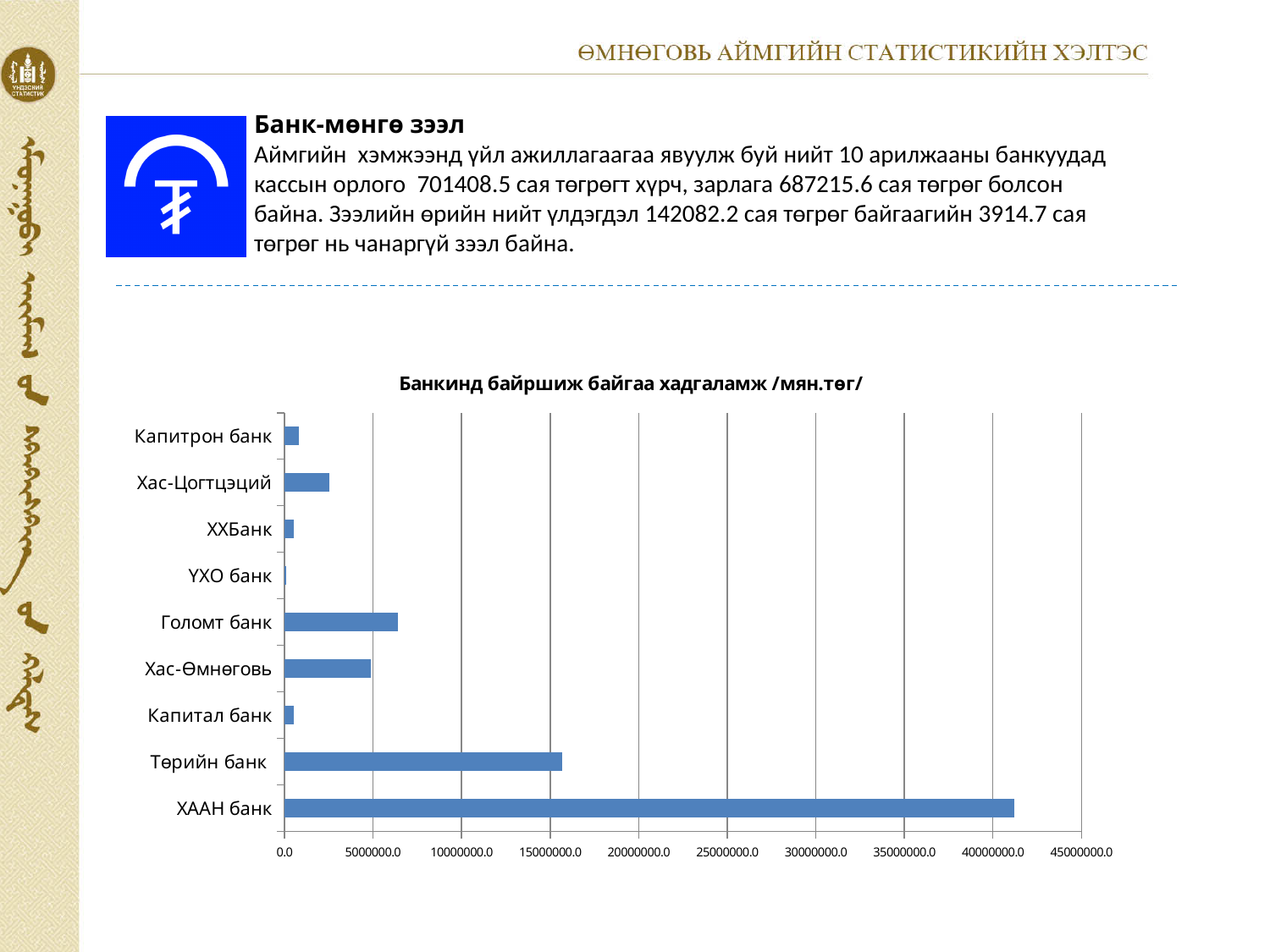
Is the value for ХААН банк greater or less than 40000000.0? greater Is the value for Хас-Цогтцэций greater or less than 5000000.0? less Which is larger, the value for Капитрон банк or the value for ХХБанк? Капитрон банк Is the value for Төрийн банк greater or less than 20000000.0? less Which is larger, the value for Төрийн банк or the value for Голомт банк? Төрийн банк What is the title of the chart? Банкинд байршиж байгаа хадгаламж /мян.төг/ What kind of chart is shown on the slide? bar chart How many banks are listed on the chart? 9 Which is larger, the value for Голомт банк or the value for Хас-Өмнөговь? Голомт банк Which bank has the lowest value on the chart? ҮХО банк Which bank has the highest value on the chart? ХААН банк